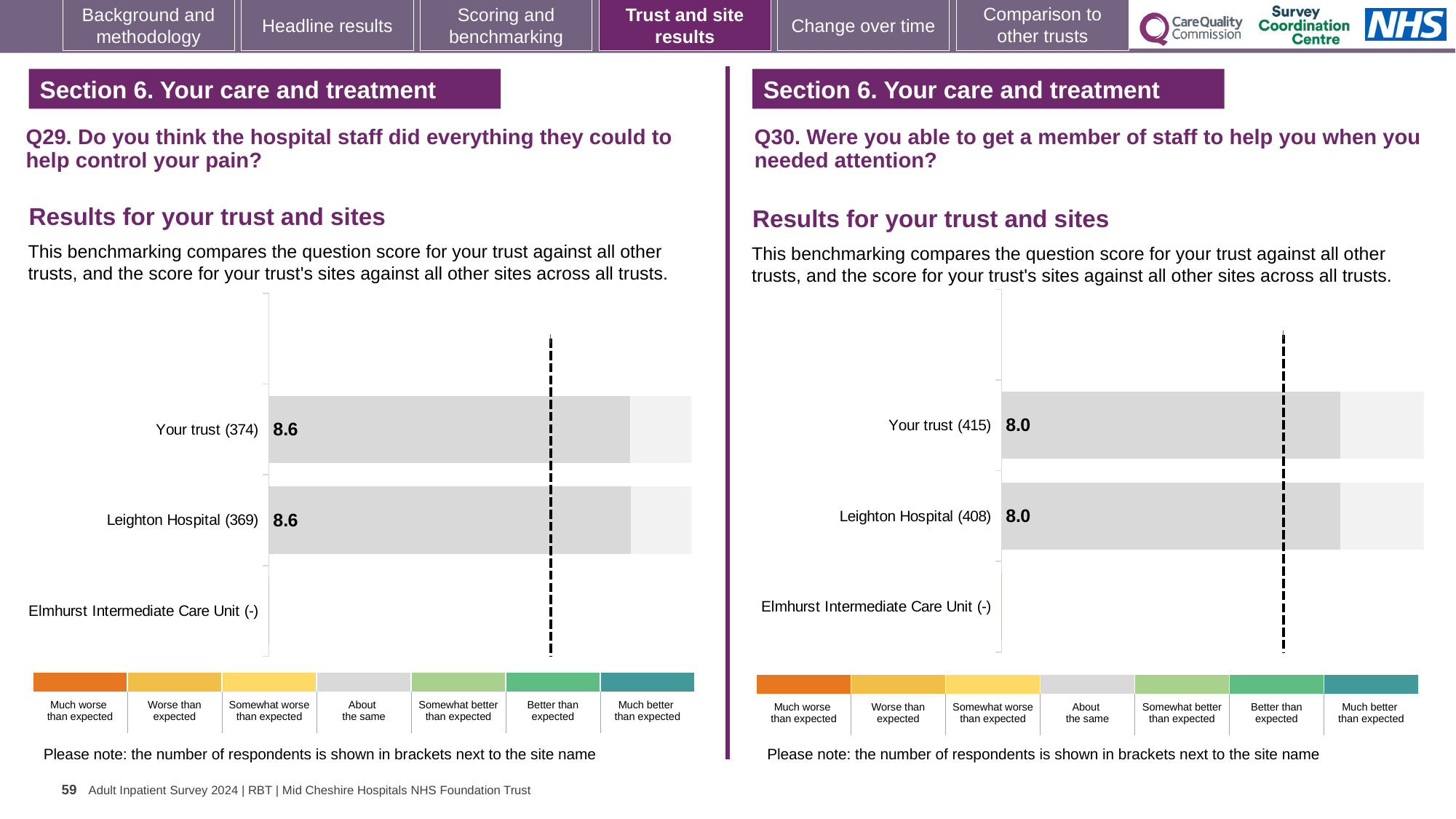
On the Q30 chart (right), which category has no score shown? Elmhurst Intermediate Care Unit On the Q29 chart (left), what is the score for Leighton Hospital? 8.6 On the Q30 chart (right), what is the score for Your trust? 8.0 On the Q29 chart (left), what is the score for Your trust? 8.6 On the Q30 chart (right), what is the difference between the scores for Your trust and Leighton Hospital? 0.0 On the Q30 chart (right), what is the score for Leighton Hospital? 8.0 How many benchmark bands does the colour key below the Q29 chart (left) list? 7 On the Q29 chart (left), how many respondents are shown in brackets for Your trust? 374 How many site/trust categories are listed on the Q29 chart (left)? 3 What kind of chart is used on the Q30 chart (right)? Bar chart On the Q29 chart (left), what is the difference between the scores for Your trust and Leighton Hospital? 0.0 On the Q30 chart (right), how many respondents are shown in brackets for Leighton Hospital? 408